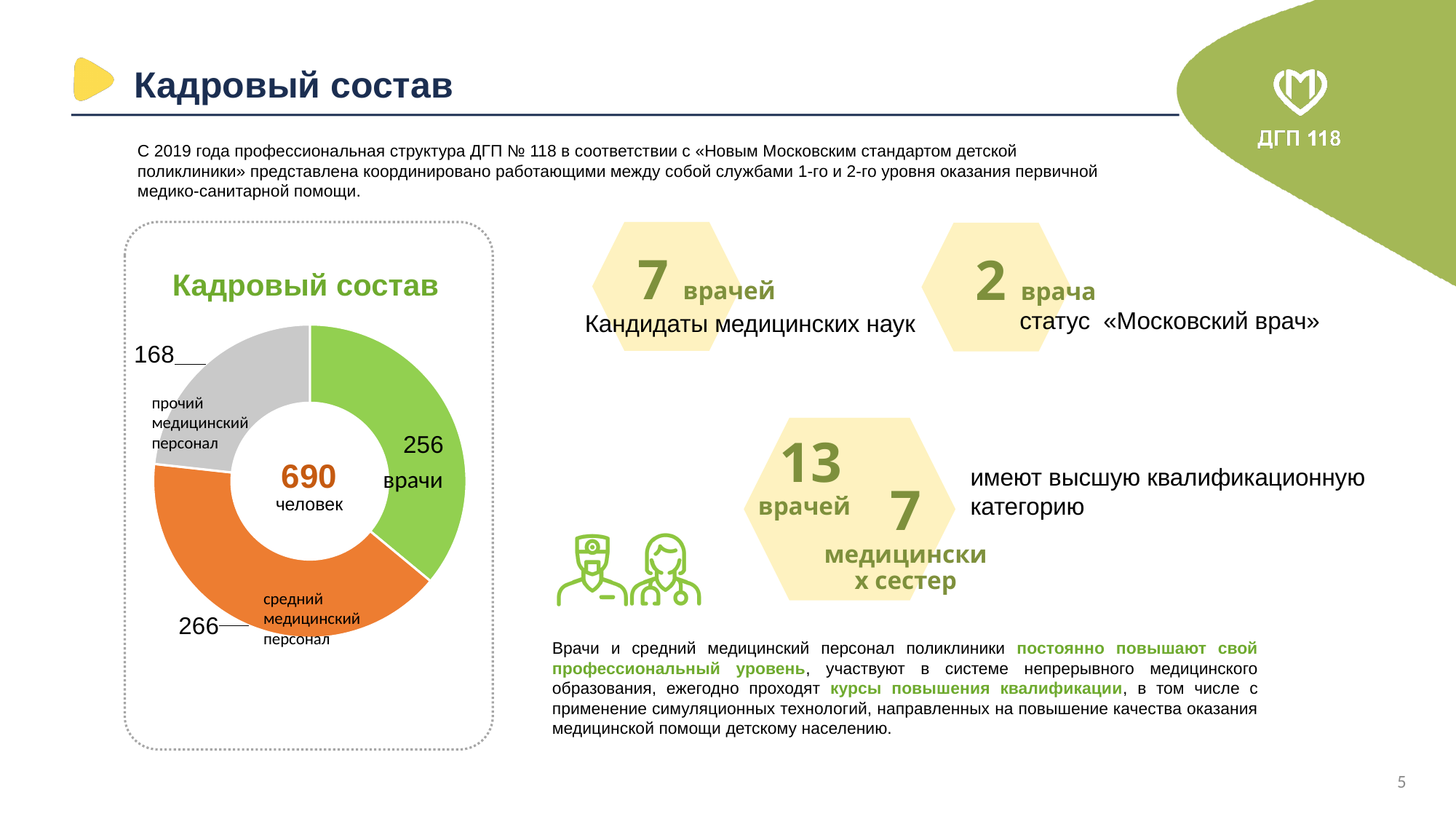
Which category has the smallest value in the chart? прочий медицинский персонал What is the difference between the values for средний медицинский персонал and врачи? 10 What is the value for врачи in the chart? 256 What total number of people is shown in the centre of the donut chart? 690 человек What kind of chart is shown on the slide? Donut (pie) chart Which category has the largest value in the chart? средний медицинский персонал What is the title of the chart? Кадровый состав What is the difference between the values for врачи and прочий медицинский персонал? 88 What is the value for средний медицинский персонал in the chart? 266 How many categories does the donut chart show? 3 Which is larger, the value for врачи or the value for средний медицинский персонал? средний медицинский персонал What is the value for прочий медицинский персонал in the chart? 168